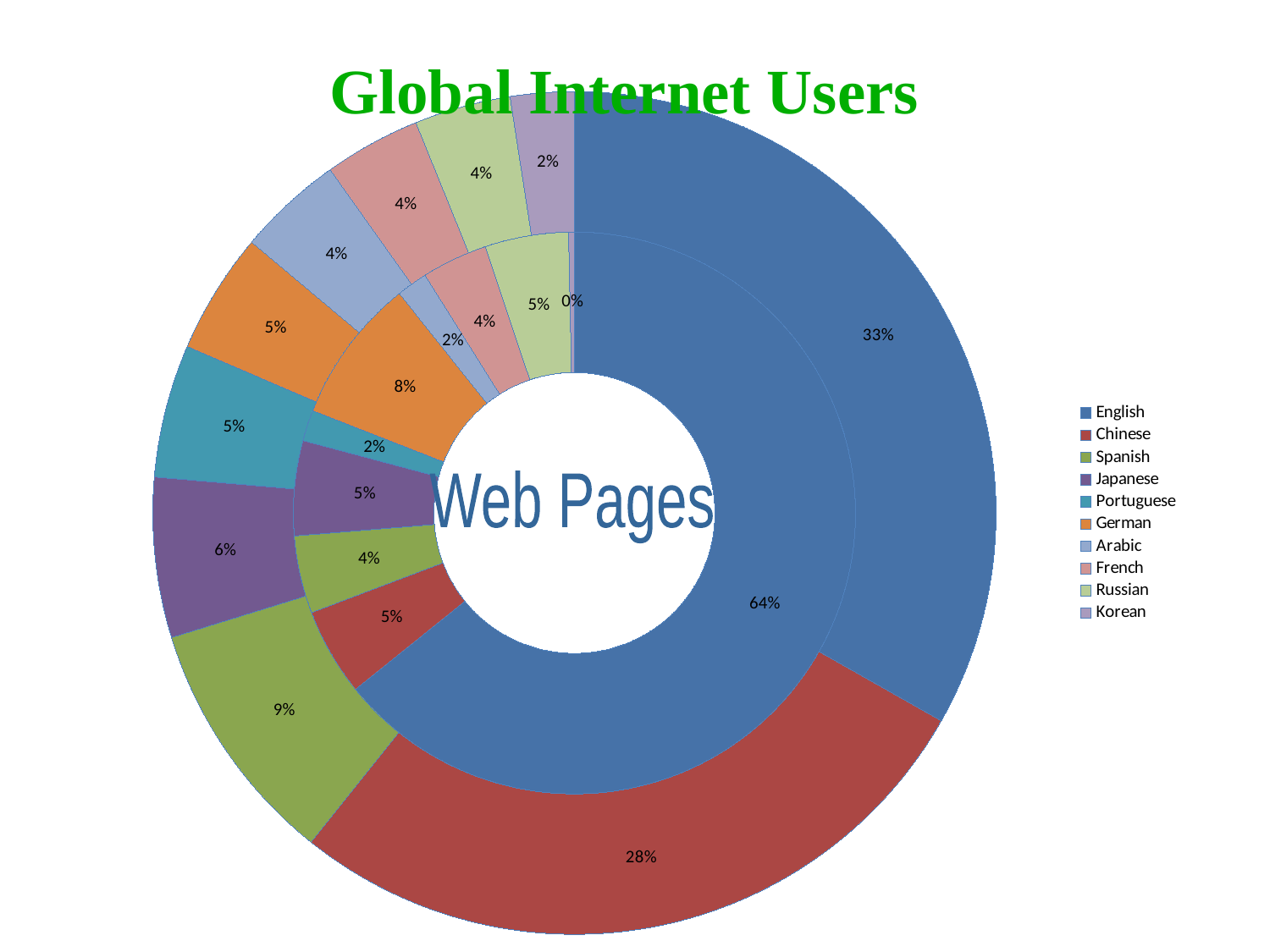
In the inner ring (Web Pages), what is the share for English? 64% Which language has the smallest share in the outer ring (Global Internet Users)? Korean In the outer ring (Global Internet Users), what is the share for English? 33% In the outer ring (Global Internet Users), what is the share for Chinese? 28% In the inner ring (Web Pages), what is the share for German? 8% Which language has the largest share in the inner ring (Web Pages)? English What is the difference between the English and Chinese shares in the outer ring (Global Internet Users)? 5% How many languages does the legend list? 10 What kind of chart is shown on the slide? doughnut chart What label is printed in the centre of the doughnut chart? Web Pages In the outer ring (Global Internet Users), which is larger, the share for Spanish or the share for Japanese? Spanish In the outer ring (Global Internet Users), what is the share for Spanish? 9%